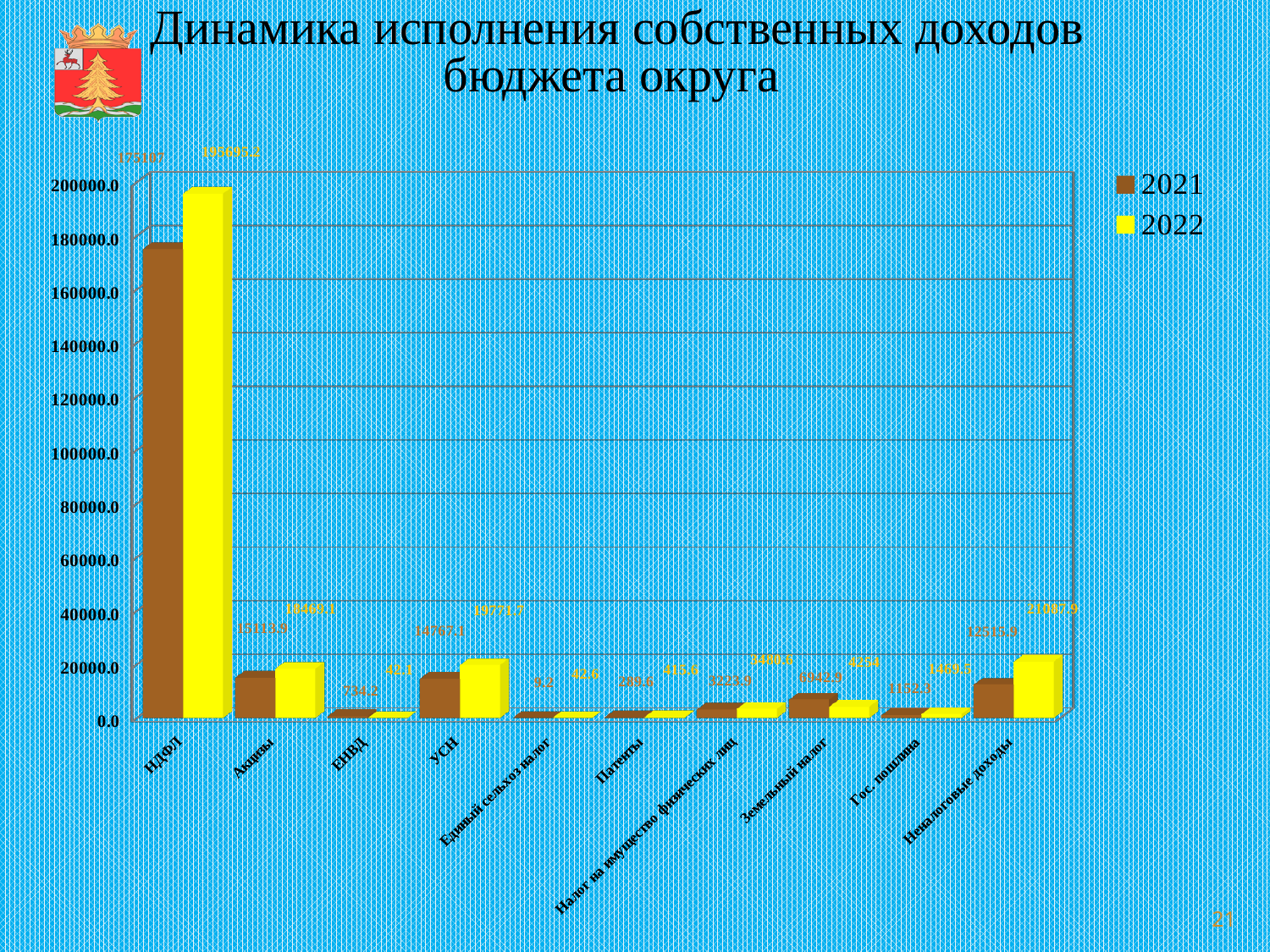
For Неналоговые доходы, which series has the larger value, 2021 or 2022? 2022 Which years are listed in the legend? 2021 and 2022 Which category has the highest value for 2022? НДФЛ How many series does the legend list? 2 Is the 2022 value for Акцизы greater or less than 40000.0? less Is the 2021 value for НДФЛ greater or less than 160000.0? greater Which category has the highest value for 2021? НДФЛ Is the 2022 value for НДФЛ greater or less than 180000.0? greater How many categories are shown on the x axis? 10 What kind of chart is shown on the slide? bar chart For Земельный налог, which series has the larger value, 2021 or 2022? 2021 What colour are the bars for the 2022 series? yellow